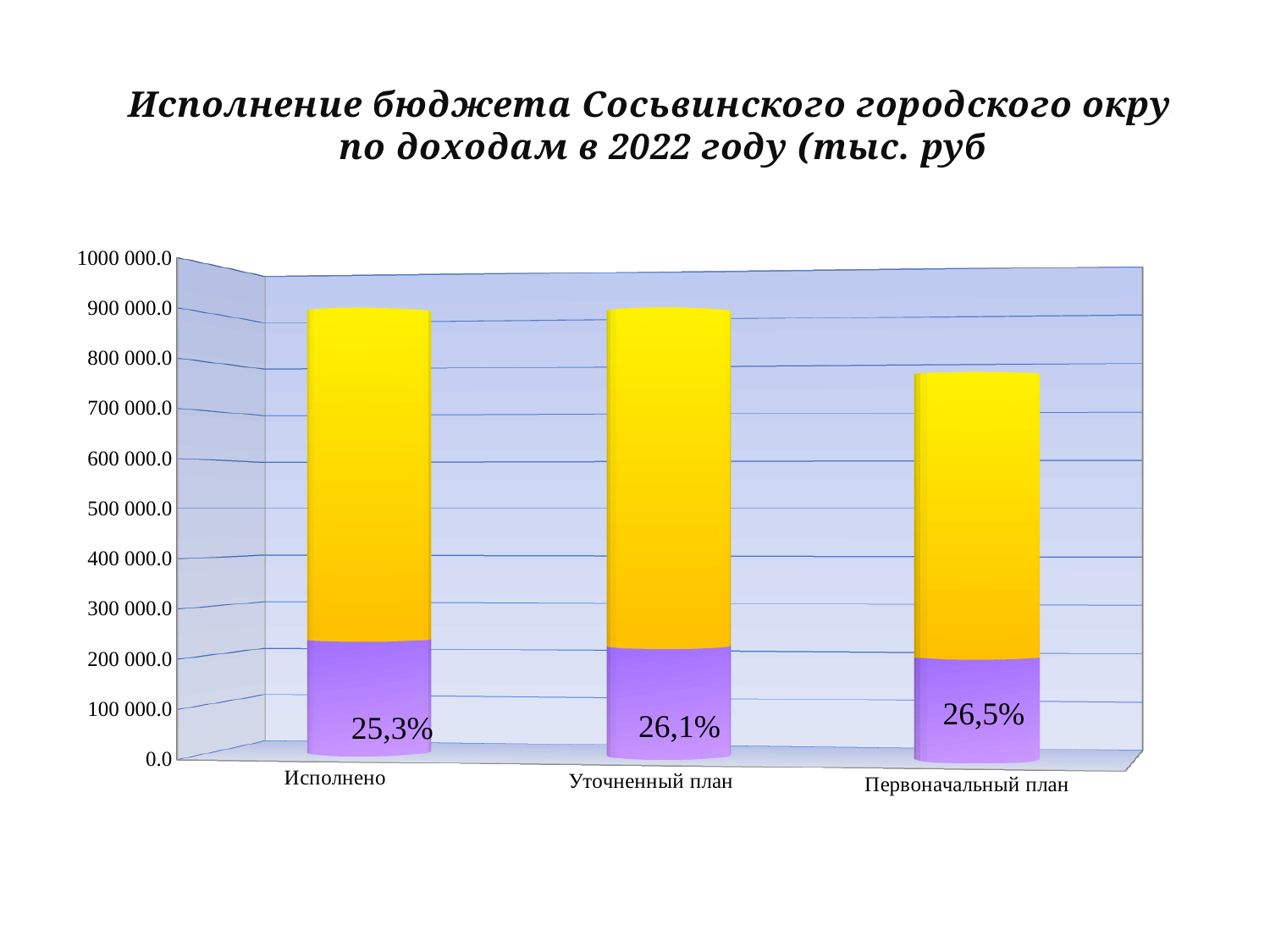
What percentage label is printed on the bar for Первоначальный план? 26,5% Which category has the highest printed percentage label? Первоначальный план What percentage label is printed on the bar for Исполнено? 25,3% Is the total bar height for Первоначальный план greater or less than 800 000.0? less What kind of chart is shown on the slide? bar chart Is the total bar height for Исполнено greater or less than 800 000.0? greater What is the difference between the percentage labels for Первоначальный план and Исполнено? 1,2% Which category has the lowest printed percentage label? Исполнено Which is larger, the total bar for Исполнено or the total bar for Первоначальный план? Исполнено Which category has the lowest total bar height? Первоначальный план What percentage label is printed on the bar for Уточненный план? 26,1% How many categories are shown on the x axis of the chart? 3